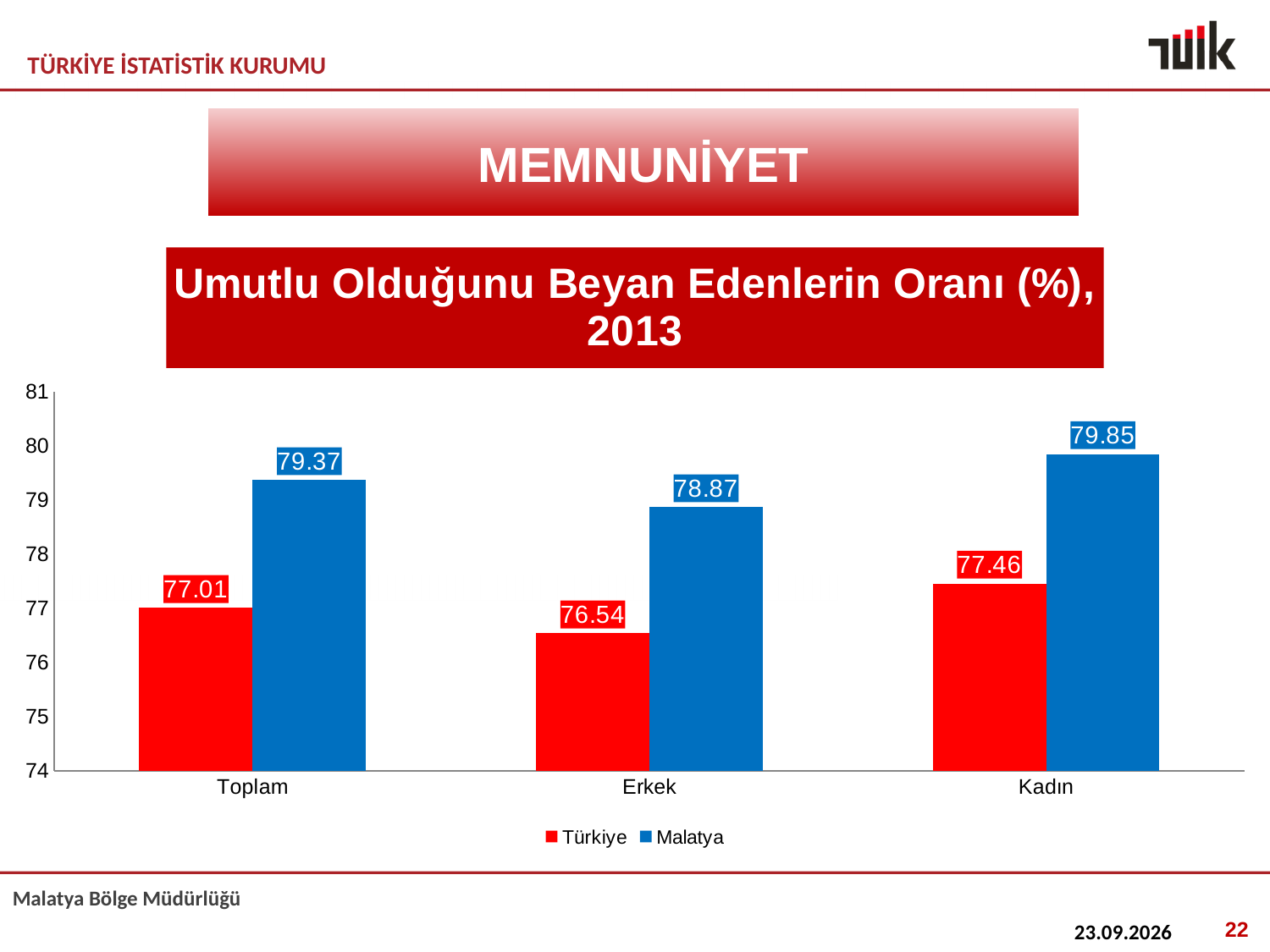
How many categories are shown on the x axis? 3 What is the value for Malatya in the Kadın category? 79.85 What kind of chart is shown on the slide? bar chart How many series does the legend list? 2 What is the difference between the Türkiye values for Kadın and Erkek? 0.92 Which is larger in the Erkek category, Türkiye or Malatya? Malatya What is the value for Türkiye in the Toplam category? 77.01 What is the value for Malatya in the Erkek category? 78.87 Which category has the highest Malatya value? Kadın What is the difference between the Malatya and Türkiye values for Toplam? 2.36 Which category has the lowest Türkiye value? Erkek Is the Malatya value for Toplam greater or less than 79? greater